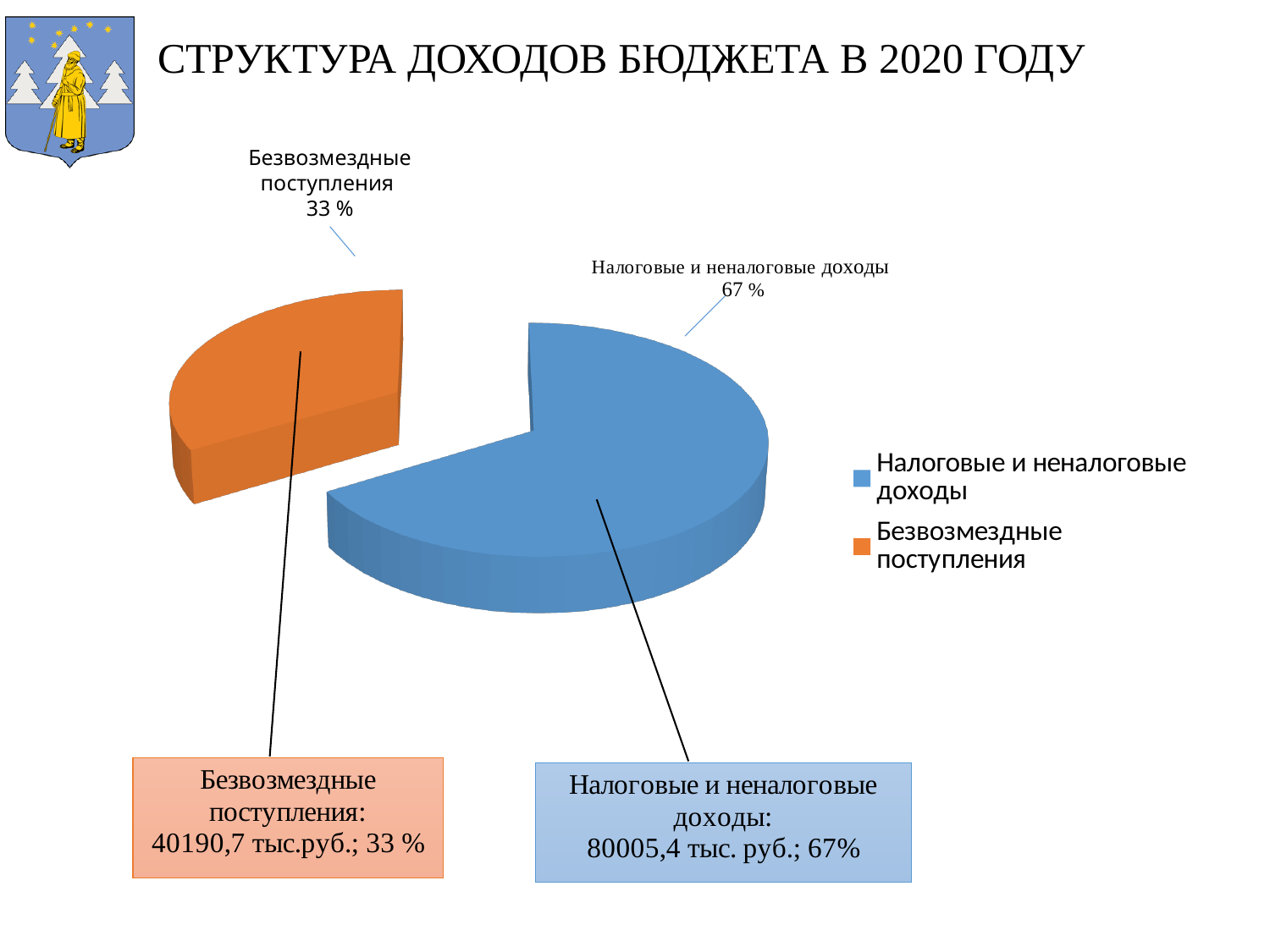
How many entries does the legend list? 2 What share of the pie does Безвозмездные поступления take? 33 % How many slices does the pie chart have? 2 Which slice of the pie is the smallest? Безвозмездные поступления What is the value shown for Безвозмездные поступления in thousand rubles? 40190,7 тыс.руб. What is the value shown for Налоговые и неналоговые доходы in thousand rubles? 80005,4 тыс. руб. What share of the pie does Налоговые и неналоговые доходы take? 67 % Which slice of the pie is the largest? Налоговые и неналоговые доходы What is the title of the chart on the slide? СТРУКТУРА ДОХОДОВ БЮДЖЕТА В 2020 ГОДУ What colour is the slice for Безвозмездные поступления? orange What kind of chart is shown on the slide? pie chart Which is larger: Налоговые и неналоговые доходы or Безвозмездные поступления? Налоговые и неналоговые доходы